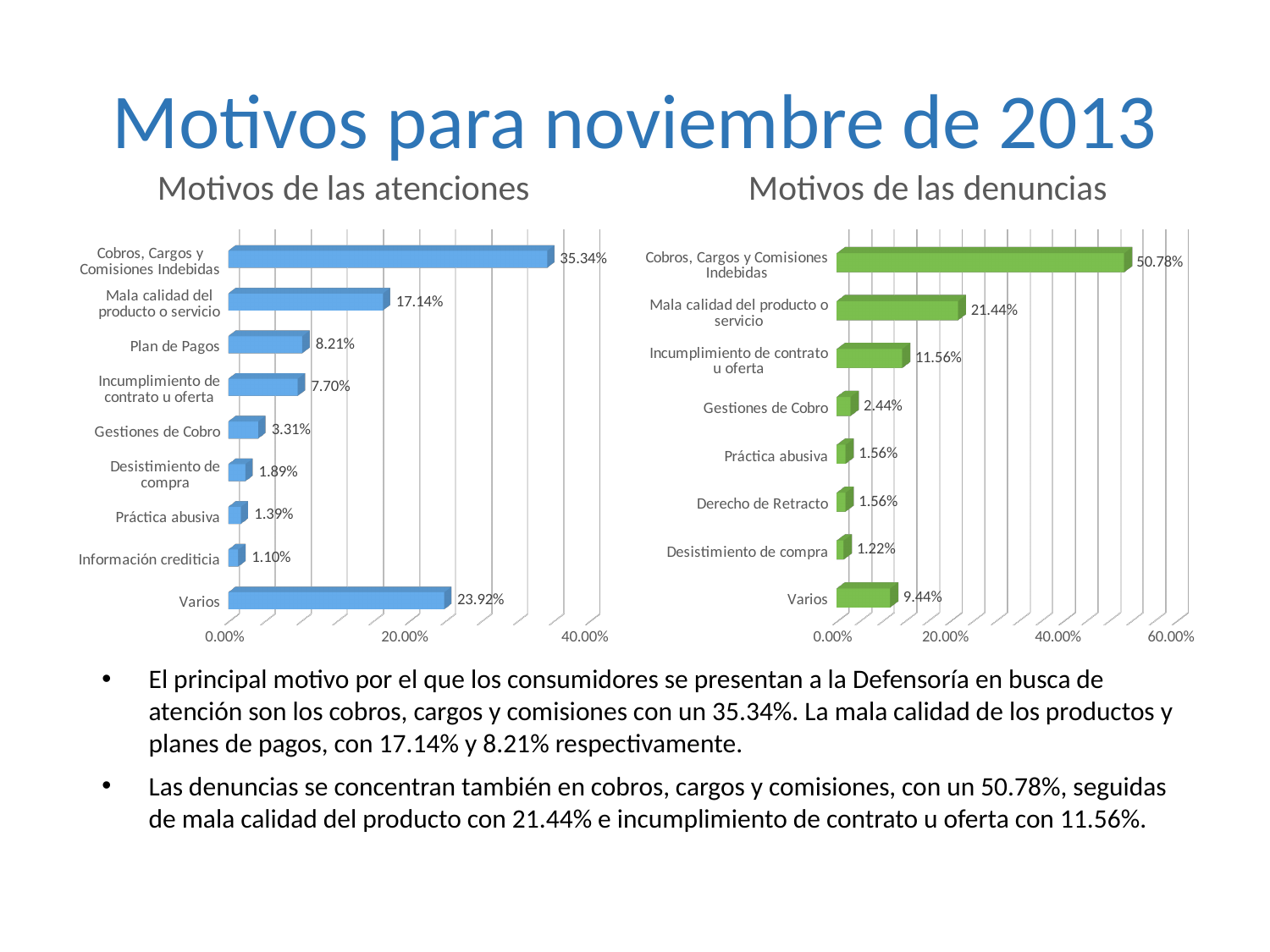
What colour are the bars in the 'Motivos de las atenciones' chart? Blue How many categories are shown in the 'Motivos de las denuncias' chart? 8 In the 'Motivos de las denuncias' chart, what is the value for Incumplimiento de contrato u oferta? 11.56% How many categories are shown in the 'Motivos de las atenciones' chart? 9 What kind of chart is 'Motivos de las denuncias'? Bar chart In the 'Motivos de las denuncias' chart, what is the difference between Cobros, Cargos y Comisiones Indebidas and Mala calidad del producto o servicio? 29.34% In the 'Motivos de las atenciones' chart, what is the value for Plan de Pagos? 8.21% In the 'Motivos de las atenciones' chart, which category has the highest value? Cobros, Cargos y Comisiones Indebidas In the 'Motivos de las denuncias' chart, which category has the lowest value? Desistimiento de compra In the 'Motivos de las denuncias' chart, is the value for Varios greater or less than 20.00%? less In the 'Motivos de las atenciones' chart, which is larger: Varios or Mala calidad del producto o servicio? Varios In the 'Motivos de las atenciones' chart, which category has the lowest value? Información crediticia